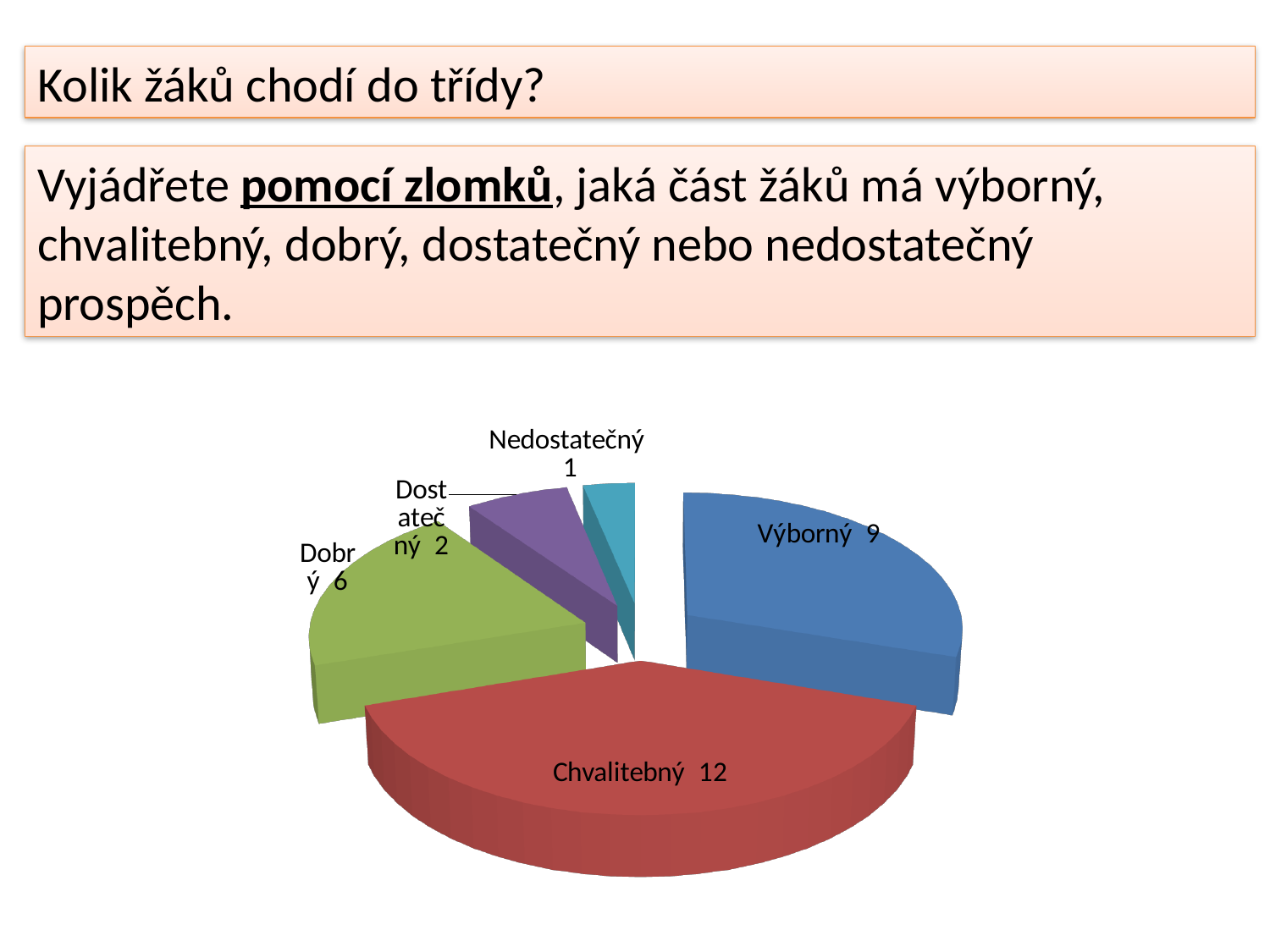
What is the total of all the values in the pie chart? 30 What is the difference between the values for Chvalitebný and Výborný? 3 What is the value for Chvalitebný? 12 Which category has the smallest slice? Nedostatečný What is the value for Výborný? 9 What is the value for Nedostatečný? 1 What is the value for Dobrý? 6 Which category has the largest slice? Chvalitebný How many slices does the pie chart have? 5 What kind of chart is shown on the slide? pie chart What share of the pie does Dobrý represent? 20% Which is larger, the value for Dobrý or the value for Dostatečný? Dobrý